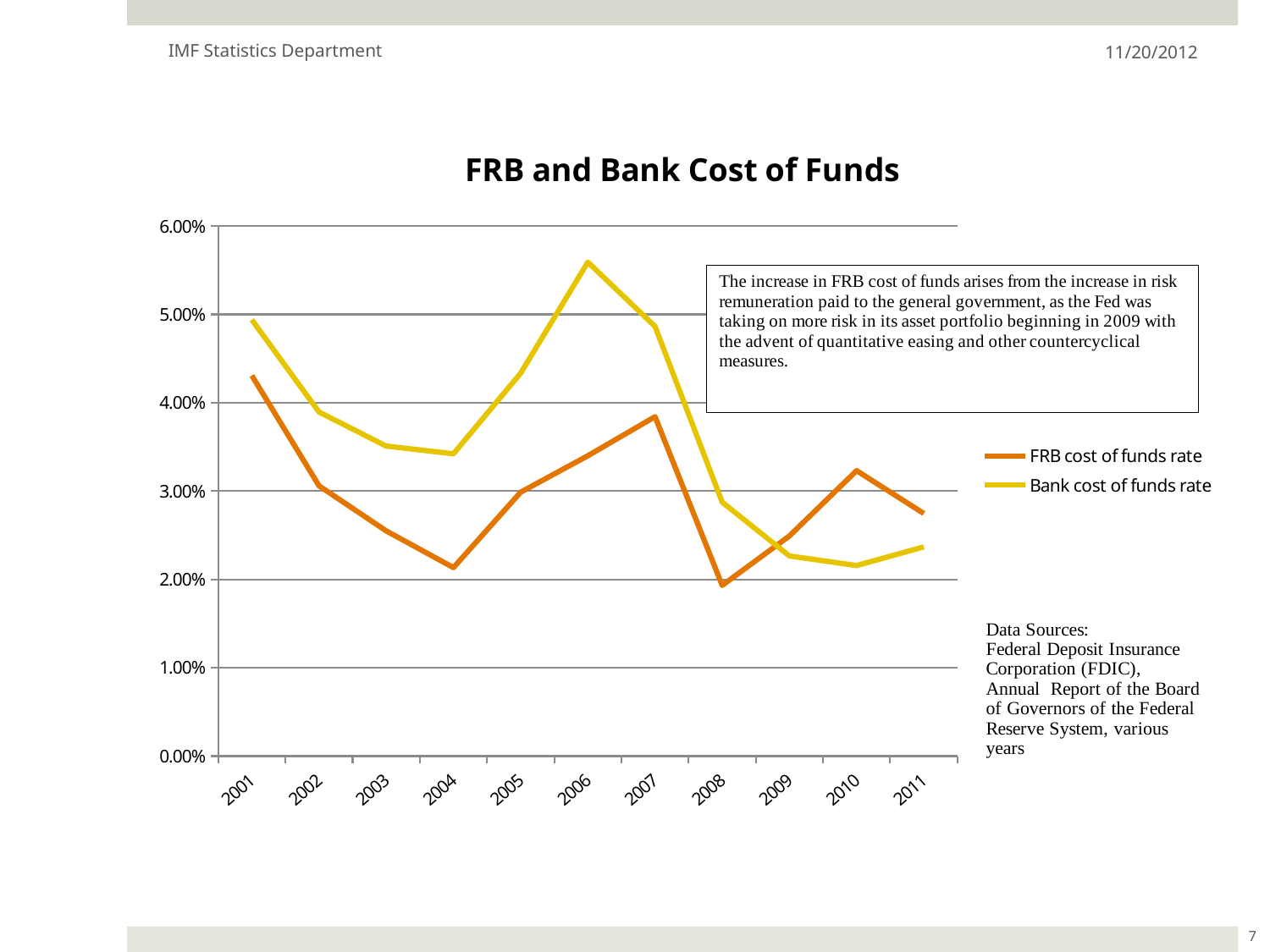
Is the FRB cost of funds rate in 2001 greater or less than 4.00%? greater How many years are plotted along the x axis? 11 Is the Bank cost of funds rate in 2006 greater or less than 5.00%? greater In which year is the FRB cost of funds rate highest? 2001 What kind of chart is shown on the slide? line chart What is the title of the chart? FRB and Bank Cost of Funds In which year is the Bank cost of funds rate highest? 2006 In 2010, which series has the higher value, FRB cost of funds rate or Bank cost of funds rate? FRB cost of funds rate Is the FRB cost of funds rate in 2008 greater or less than 2.00%? less In which year is the FRB cost of funds rate lowest? 2008 How many series does the legend list? 2 Does the Bank cost of funds rate rise or fall from 2006 to 2010? fall